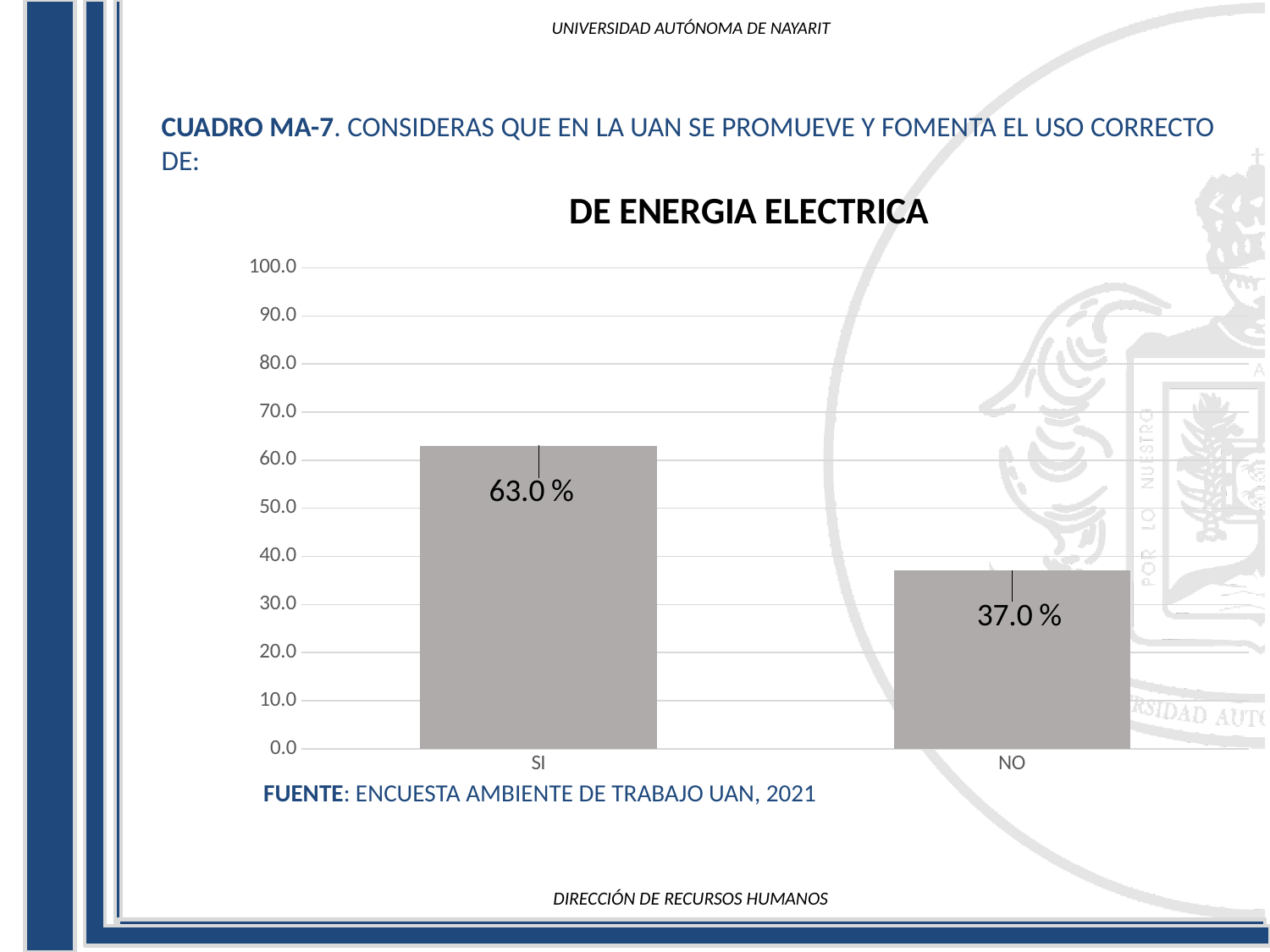
What kind of chart is shown? bar chart Which category has the lowest value? NO What is the highest value shown on the y axis? 100.0 Which is larger, the value for SI or the value for NO? SI How many categories are shown on the x axis? 2 Is the value for NO greater or less than 40.0? less What is the difference between the values for SI and NO? 26.0 % What is the value for NO? 37.0 % What is the value for SI? 63.0 % Which category has the highest value? SI Is the value for SI greater or less than 60.0? greater What is the title of the chart? DE ENERGIA ELECTRICA